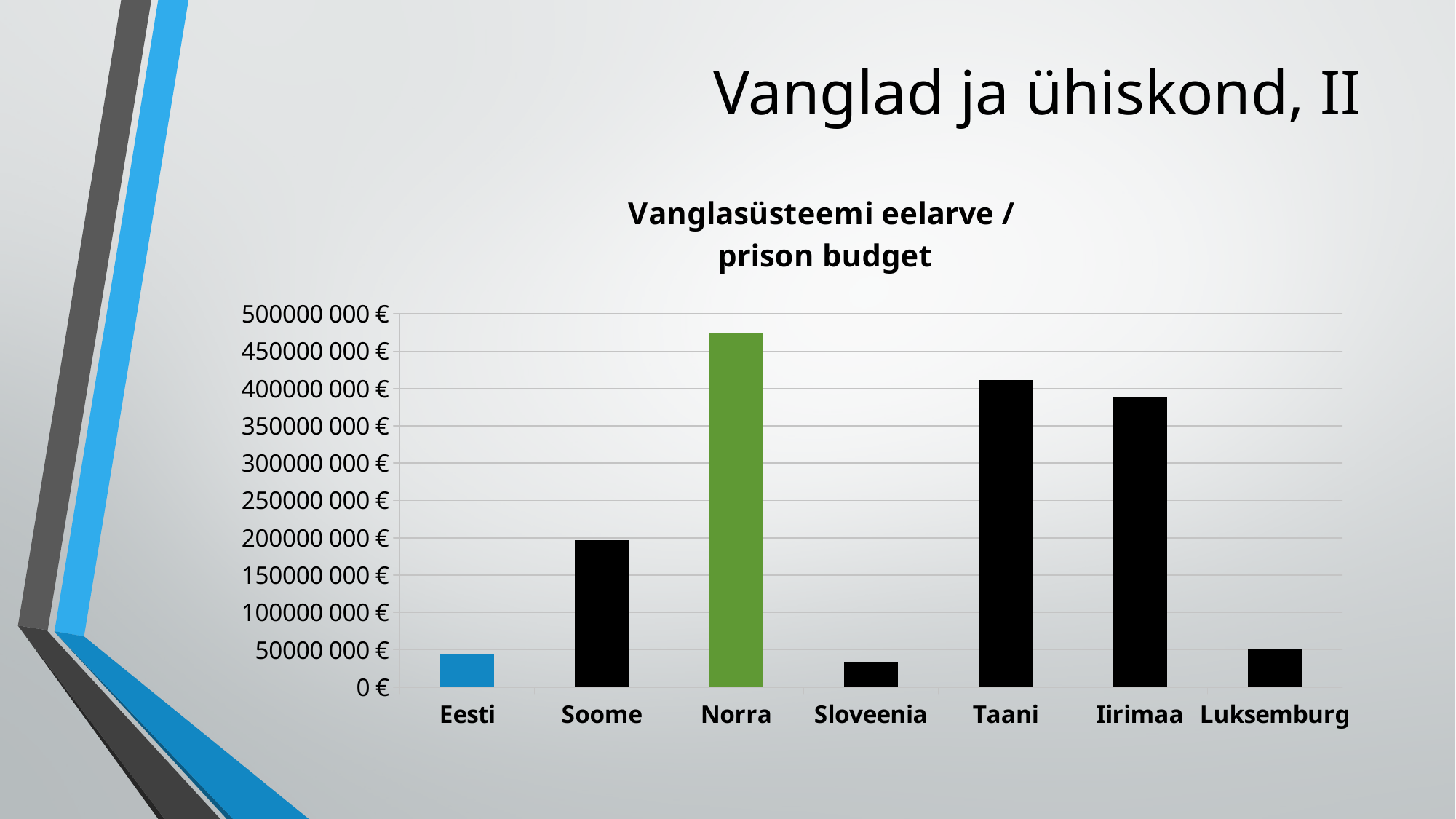
Which has the larger prison budget, Soome or Eesti? Soome Is the value for Iirimaa greater or less than 400000 000 €? less What colour is the bar for Norra? green What kind of chart is shown on the slide? bar chart Which has the larger prison budget, Taani or Iirimaa? Taani Is the value for Sloveenia greater or less than 50000 000 €? less Is the value for Soome greater or less than 150000 000 €? greater What is the title of the chart? Vanglasüsteemi eelarve / prison budget How many countries are shown on the x axis of the chart? 7 Which country has the lowest prison budget in the chart? Sloveenia Which country has the highest prison budget in the chart? Norra